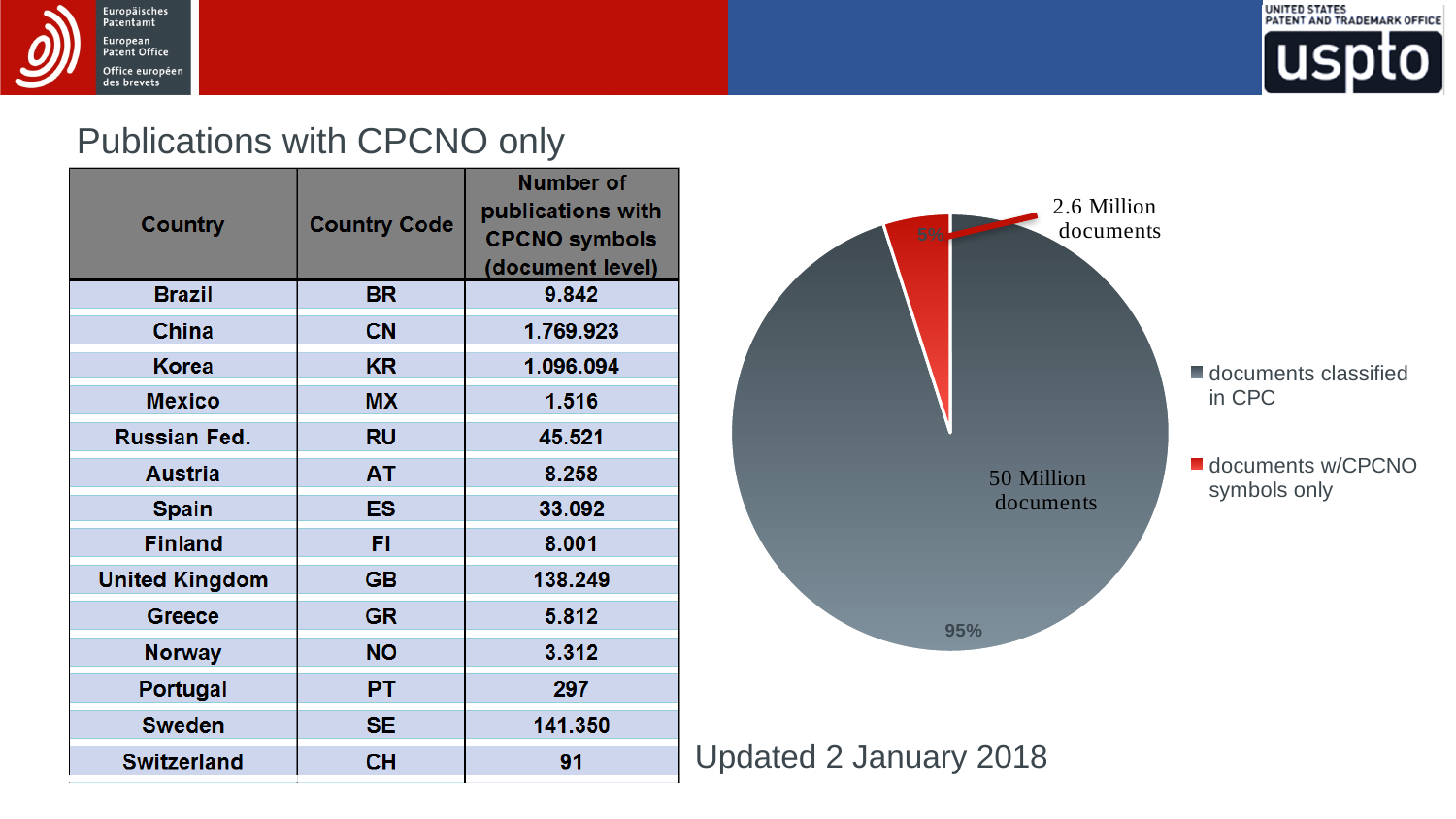
Which slice of the pie chart is the smallest? documents w/CPCNO symbols only How many slices does the pie chart have? 2 By how many percentage points does the share of documents classified in CPC exceed the share of documents w/CPCNO symbols only? 90 percentage points What share of the pie is labelled "documents w/CPCNO symbols only"? 5% What share of the pie is labelled "documents classified in CPC"? 95% According to the annotation on the pie chart, how many documents have CPCNO symbols only? 2.6 Million documents According to the annotation on the pie chart, how many documents are classified in CPC? 50 Million documents How many entries does the pie chart's legend list? 2 Which slice of the pie chart is the largest? documents classified in CPC What colour is the slice for documents w/CPCNO symbols only? red Which is larger in the pie chart: the share of documents classified in CPC or the share of documents w/CPCNO symbols only? documents classified in CPC What kind of chart is shown on the slide? pie chart